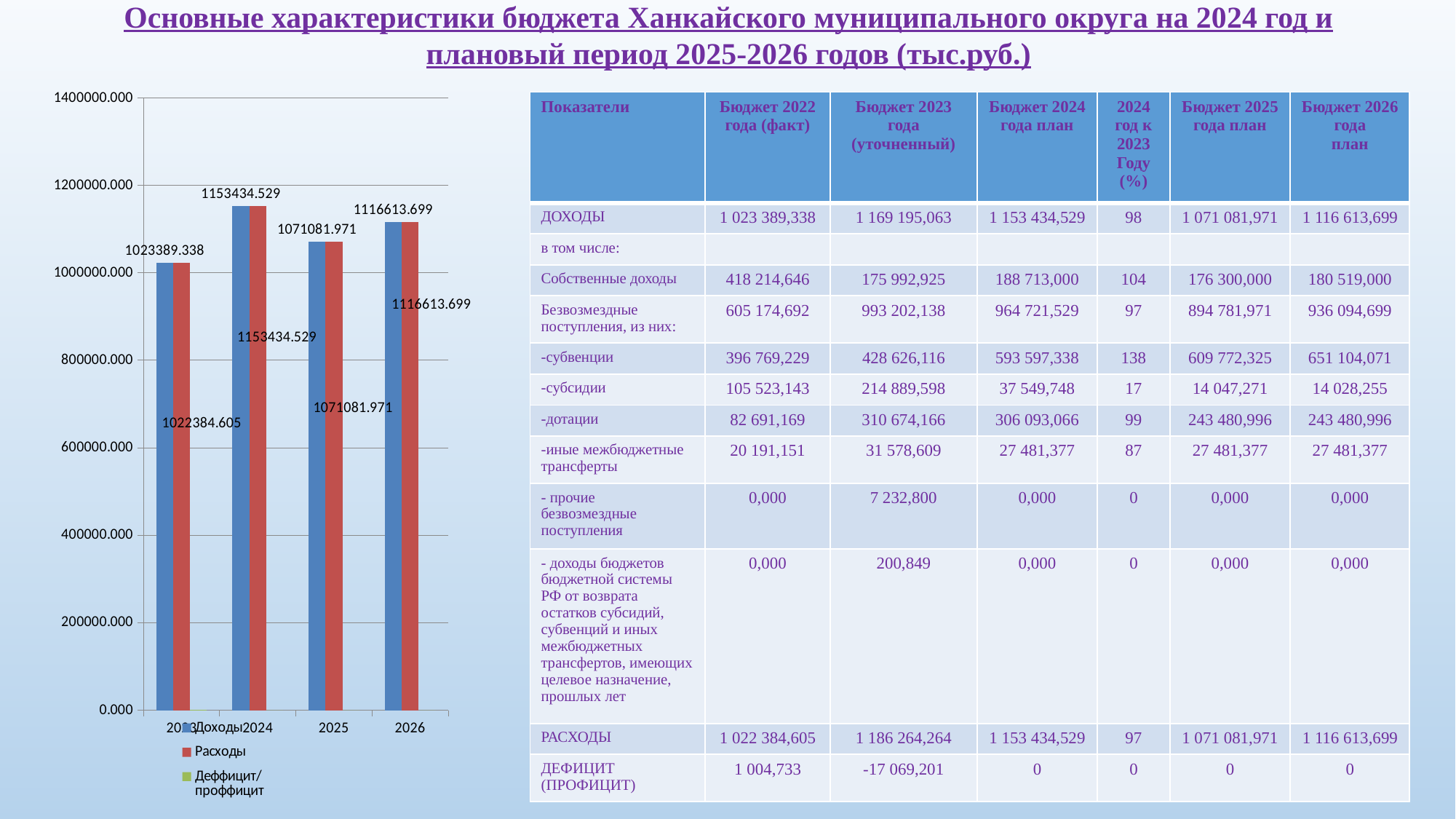
What kind of chart is shown on the left of the slide? bar chart What is the value of Расходы for 2025 in the chart? 1071081.971 Which year has the highest Доходы value in the chart? 2024 Which is larger in the chart: Доходы for 2025 or Доходы for 2026? Доходы for 2026 Which year group has the lowest Расходы value in the chart? the first (leftmost) group What is the difference between Доходы in 2024 and Доходы in 2025 in the chart? 82352.558 What colour are the Расходы bars in the chart? red Is the Расходы value for 2024 greater or less than 1000000.000? greater What is the value of Доходы for 2026 in the chart? 1116613.699 How many series does the chart legend list? 3 What is the value of Расходы for the first (leftmost) year group in the chart? 1022384.605 What is the value of Доходы for 2024 in the chart? 1153434.529